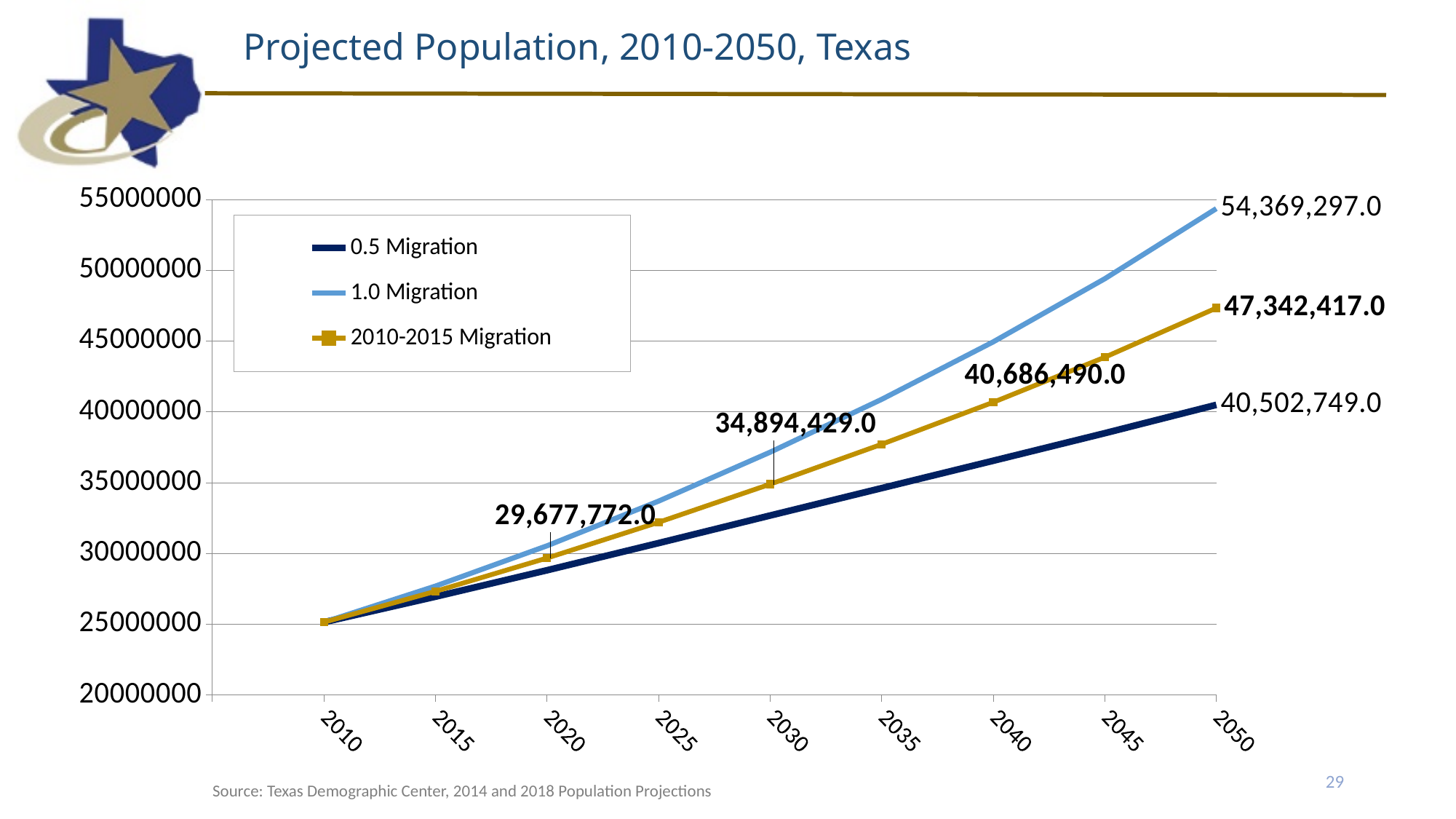
How many series does the legend list? 3 What is the projected population for the 2010-2015 Migration scenario in 2030? 34,894,429.0 What is the difference between the 1.0 Migration and 0.5 Migration projections in 2050? 13,866,548.0 Is the value for the 0.5 Migration scenario in 2030 greater or less than 35000000? less What is the projected population for the 1.0 Migration scenario in 2050? 54,369,297.0 What is the projected population for the 2010-2015 Migration scenario in 2050? 47,342,417.0 Which scenario has the highest projected population in 2050? 1.0 Migration What is the projected population for the 0.5 Migration scenario in 2050? 40,502,749.0 What kind of chart is shown on the slide? Line chart What is the projected population for the 2010-2015 Migration scenario in 2020? 29,677,772.0 By how much does the 2010-2015 Migration projection increase from 2040 to 2050? 6,655,927.0 Do the projected population values rise or fall from 2010 to 2050? Rise